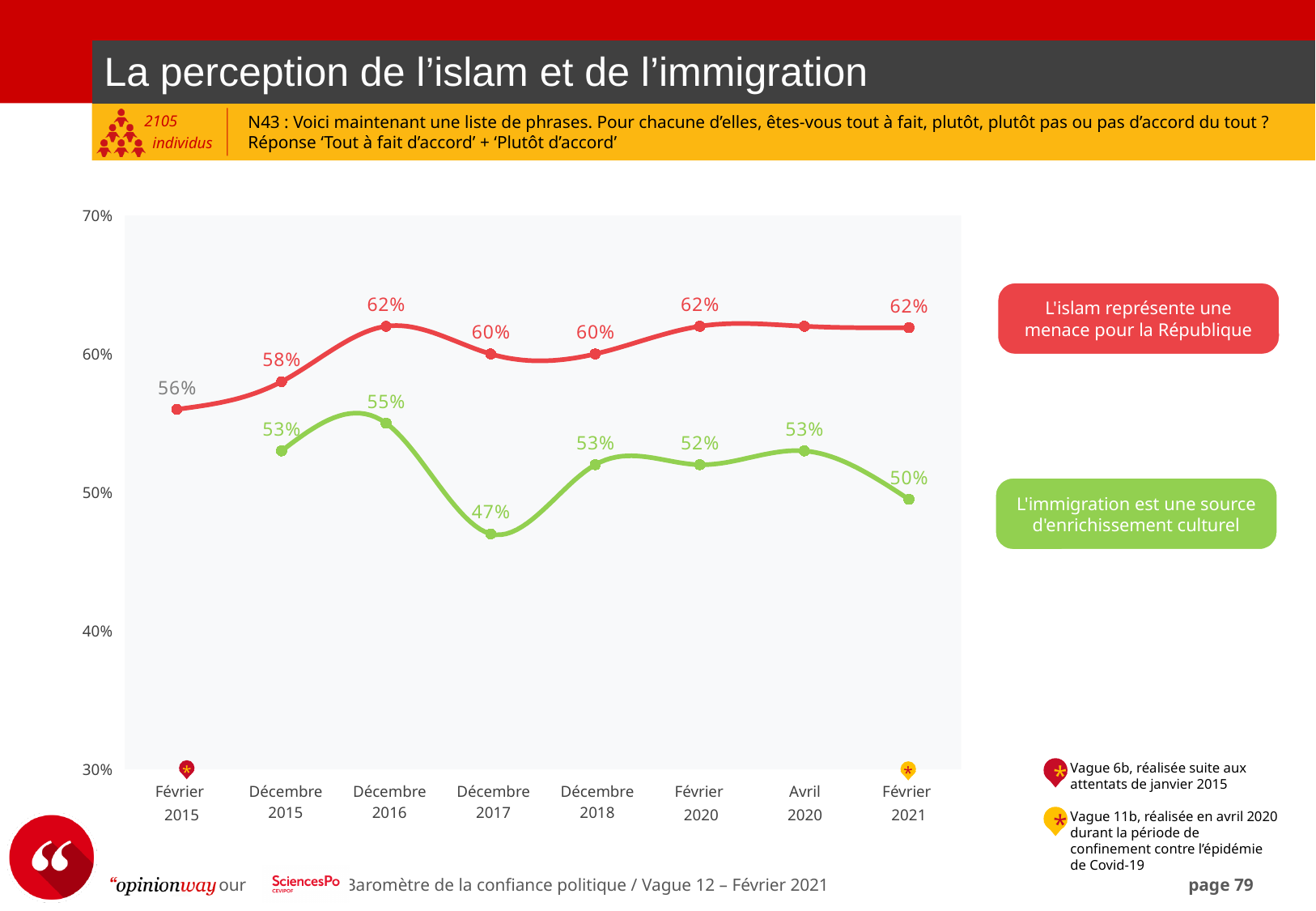
By how many percentage points did 'L'islam représente une menace pour la République' rise from Février 2015 to Décembre 2016? 6 percentage points At which date is the value for 'L'immigration est une source d'enrichissement culturel' highest? Décembre 2016 In Décembre 2015, which statement has the higher agreement: 'L'islam représente une menace pour la République' or 'L'immigration est une source d'enrichissement culturel'? L'islam représente une menace pour la République What is the value for 'L'immigration est une source d'enrichissement culturel' in Février 2021? 50% How many series are plotted on the chart? 2 Does the value for 'L'immigration est une source d'enrichissement culturel' rise or fall between Décembre 2016 and Décembre 2017? Fall What is the value for 'L'islam représente une menace pour la République' in Février 2015? 56% What kind of chart is shown on the slide? Line chart What is the value for 'L'immigration est une source d'enrichissement culturel' in Décembre 2017? 47% How many survey dates are shown on the x axis? 8 At which date is the value for 'L'immigration est une source d'enrichissement culturel' lowest? Décembre 2017 Is the value for 'L'islam représente une menace pour la République' in Avril 2020 greater or less than 60%? greater